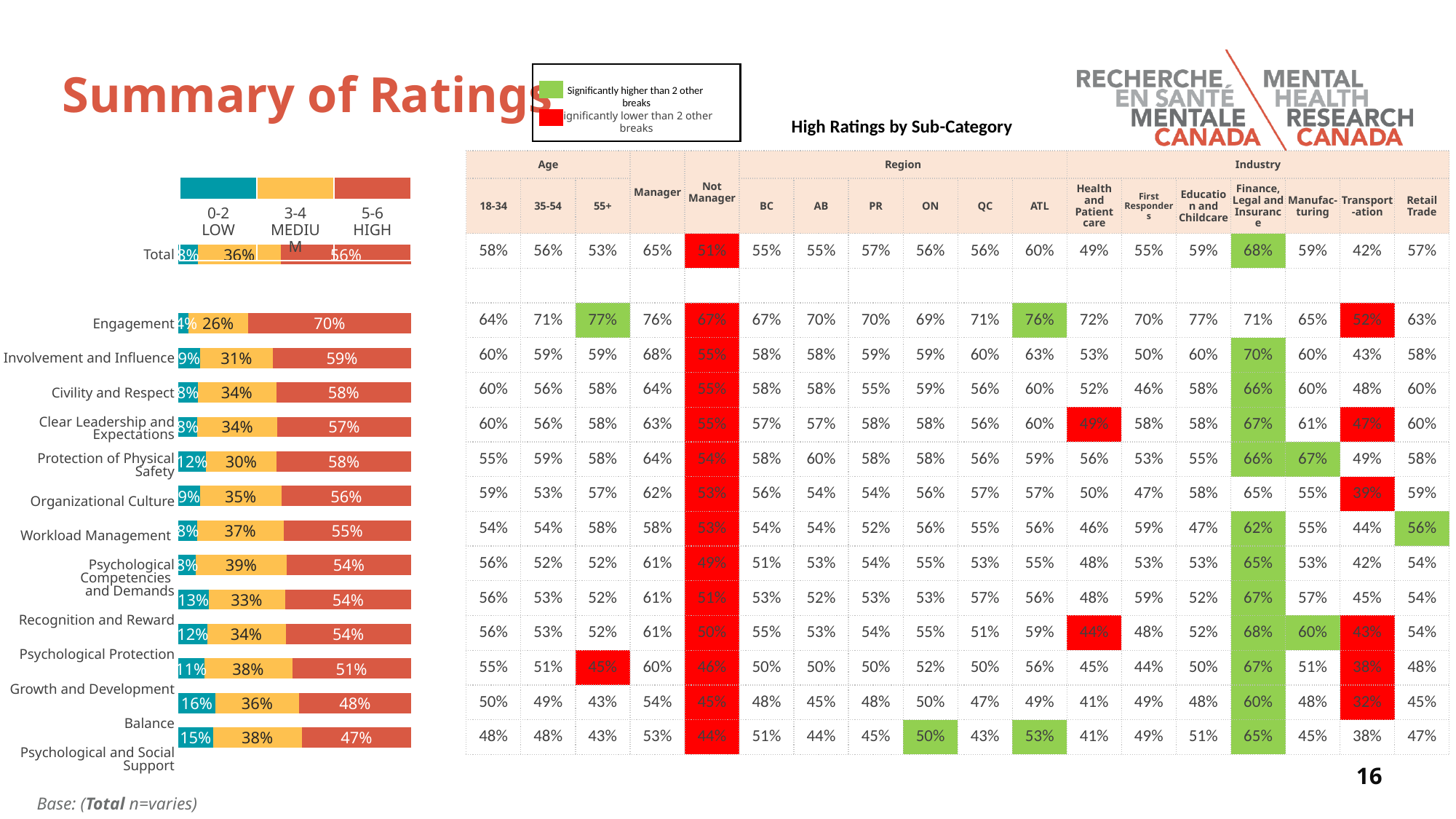
What kind of chart is shown on the left of the slide? Stacked bar chart In the bar chart, which has the larger 5-6 HIGH value, Engagement or Involvement and Influence? Engagement In the bar chart, what is the 0-2 LOW value for Involvement and Influence? 9% How many series does the legend of the bar chart list? 3 In the bar chart, what is the difference between the 5-6 HIGH values for Engagement and Civility and Respect? 12 percentage points In the bar chart, what is the 5-6 HIGH value for Engagement? 70% What is the total of the stacked bar for Engagement? 100% In the bar chart, what is the 3-4 MEDIUM value for Civility and Respect? 34% How many categories, including Total, are plotted in the bar chart? 14 What are the three legend entries of the bar chart? 0-2 LOW, 3-4 MEDIUM, 5-6 HIGH In the bar chart, what is the 3-4 MEDIUM value for Total? 36% In the bar chart, which category has the highest 5-6 HIGH value? Engagement